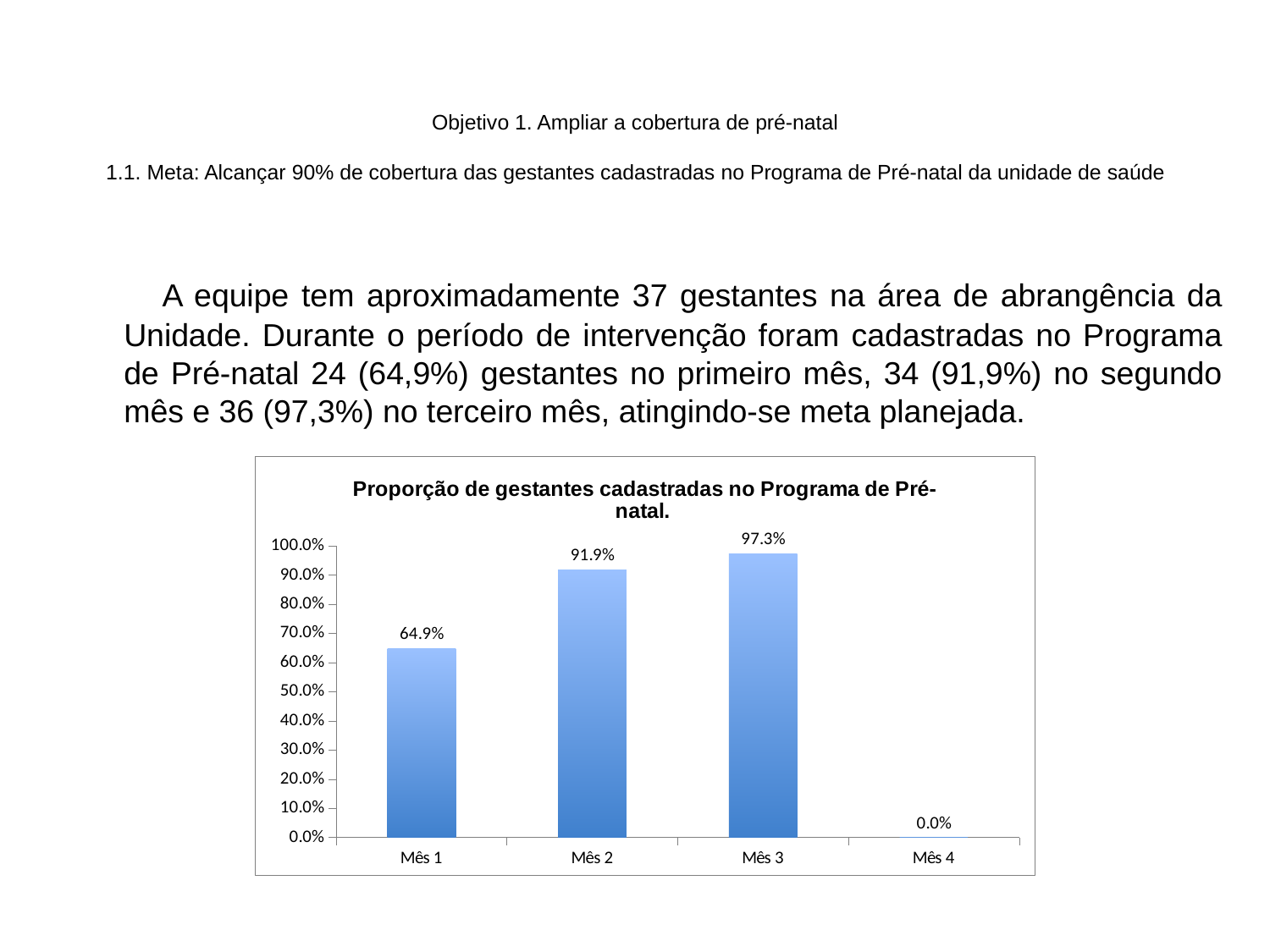
What kind of chart is shown on the slide? bar chart What is the value for Mês 1? 64.9% What is the value for Mês 4? 0.0% Which is larger, the value for Mês 1 or the value for Mês 2? Mês 2 What is the value for Mês 2? 91.9% How many categories are shown on the x axis? 4 What is the value for Mês 3? 97.3% What is the difference between the values for Mês 2 and Mês 1? 27.0% What is the difference between the values for Mês 3 and Mês 1? 32.4% Which month has the highest value? Mês 3 Is the value for Mês 2 greater or less than 90.0%? greater Which month has the lowest value? Mês 4